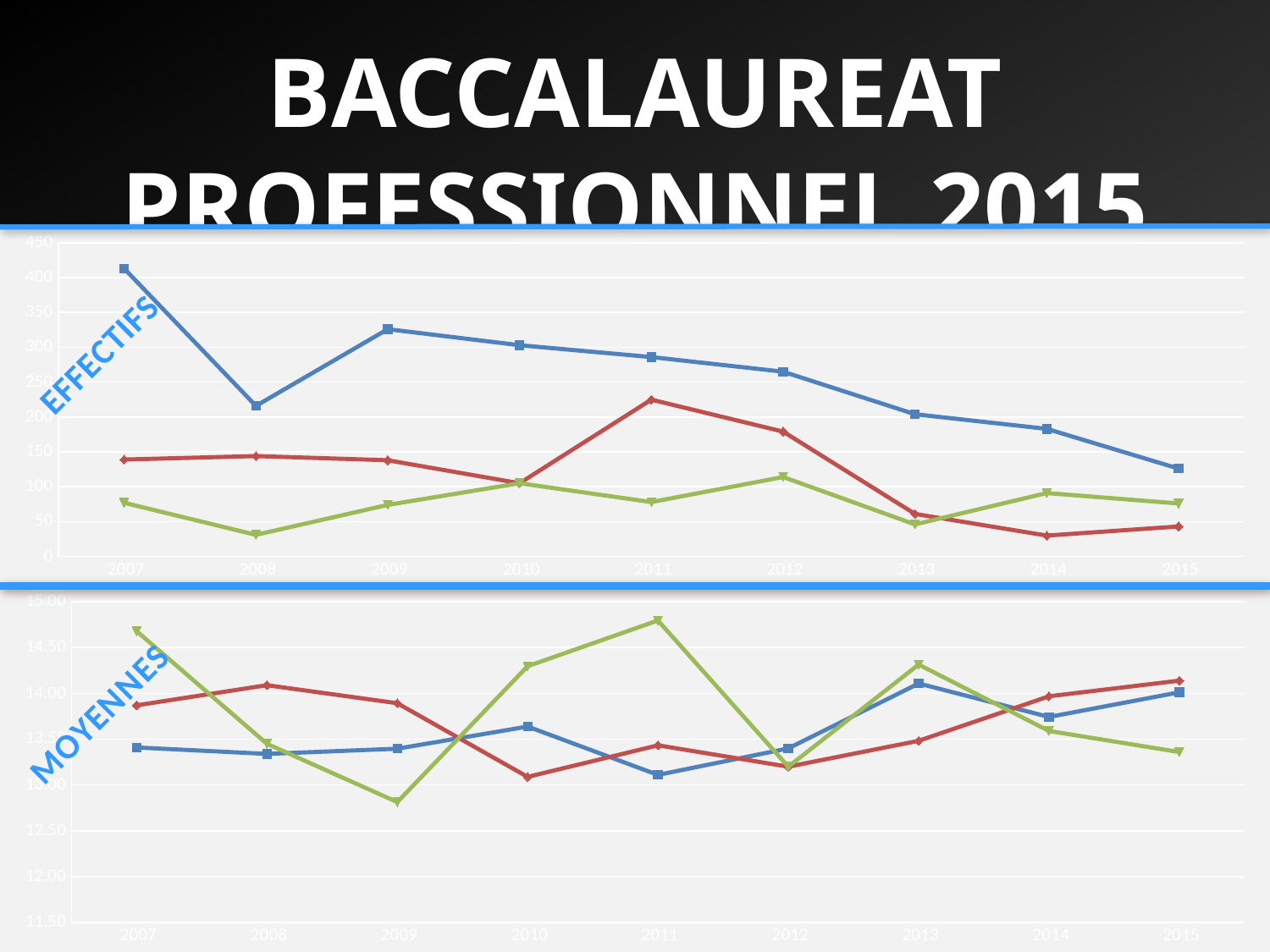
In the EFFECTIFS chart, in which year does the red series reach its peak? 2011 In the EFFECTIFS chart, does the blue series rise or fall from 2009 to 2015? fall How many years are plotted along the x axis of the EFFECTIFS chart? 9 In the MOYENNES chart, in which year is the green series at its lowest? 2009 What kind of chart is the top chart labelled EFFECTIFS? line chart In the MOYENNES chart, is the value of the green series in 2009 greater or less than 13.00? less What kind of chart is the bottom chart labelled MOYENNES? line chart In the EFFECTIFS chart, which series has the larger value in 2007, the blue or the red? blue In the EFFECTIFS chart, in which year is the blue series at its highest? 2007 In the EFFECTIFS chart, in which year is the blue series at its lowest? 2015 In the EFFECTIFS chart, is the value of the red series in 2014 greater or less than 50? less In the EFFECTIFS chart, is the value of the blue series in 2007 greater or less than 350? greater